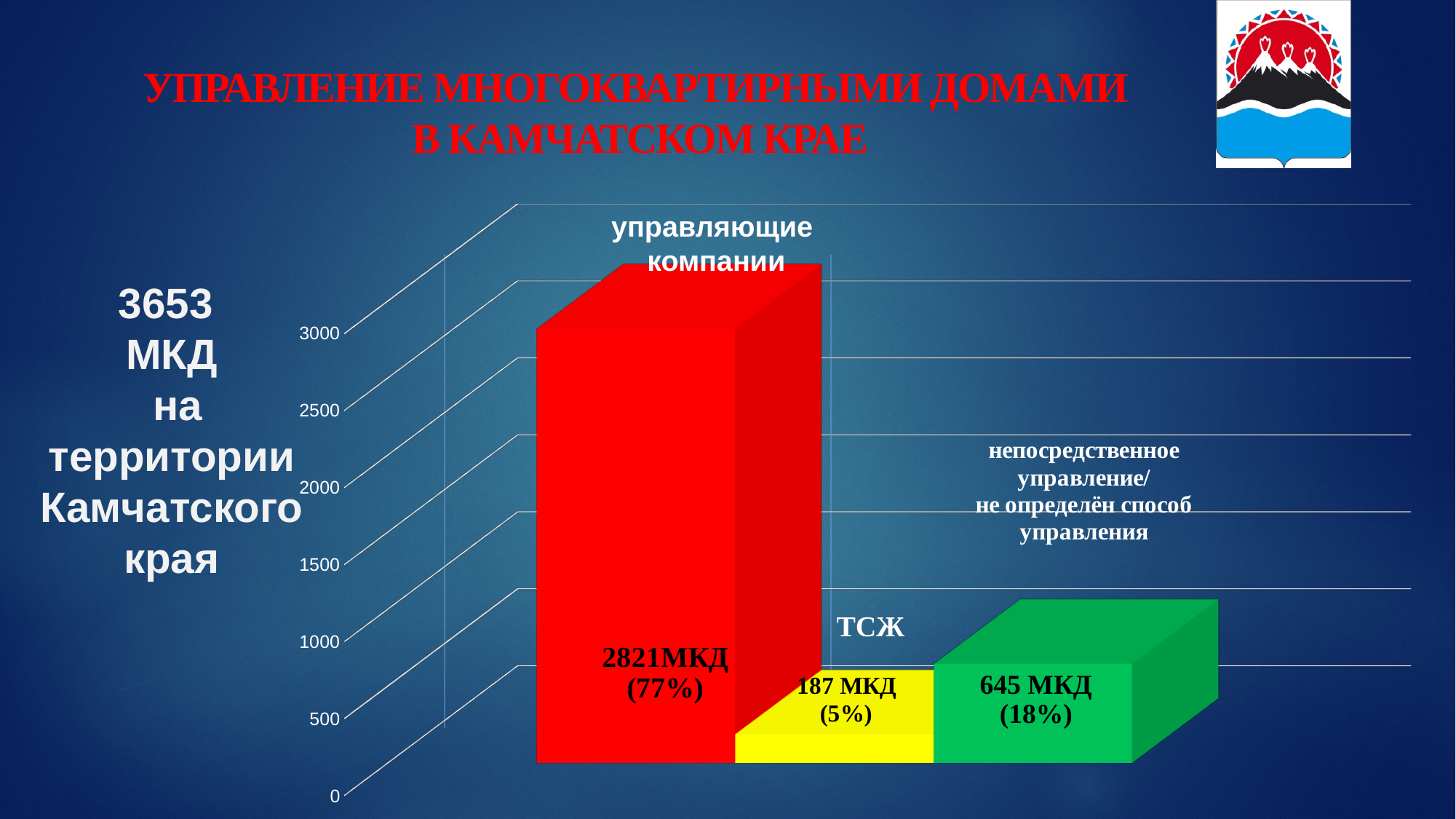
What is the total number of МКД on the territory of Камчатский край stated on the slide? 3653 What percentage share is shown for управляющие компании? 77% Which has more МКД: ТСЖ or непосредственное управление / не определён способ управления? непосредственное управление / не определён способ управления How many МКД fall under непосредственное управление / не определён способ управления? 645 How many categories are shown in the chart? 3 How many МКД are managed by управляющие компании according to the chart? 2821 What percentage share is shown for ТСЖ? 5% Which category has the highest number of МКД? управляющие компании Which category has the lowest number of МКД? ТСЖ What kind of chart is shown on the slide? bar chart How many МКД are managed by ТСЖ according to the chart? 187 What is the difference in МКД between управляющие компании and ТСЖ? 2634